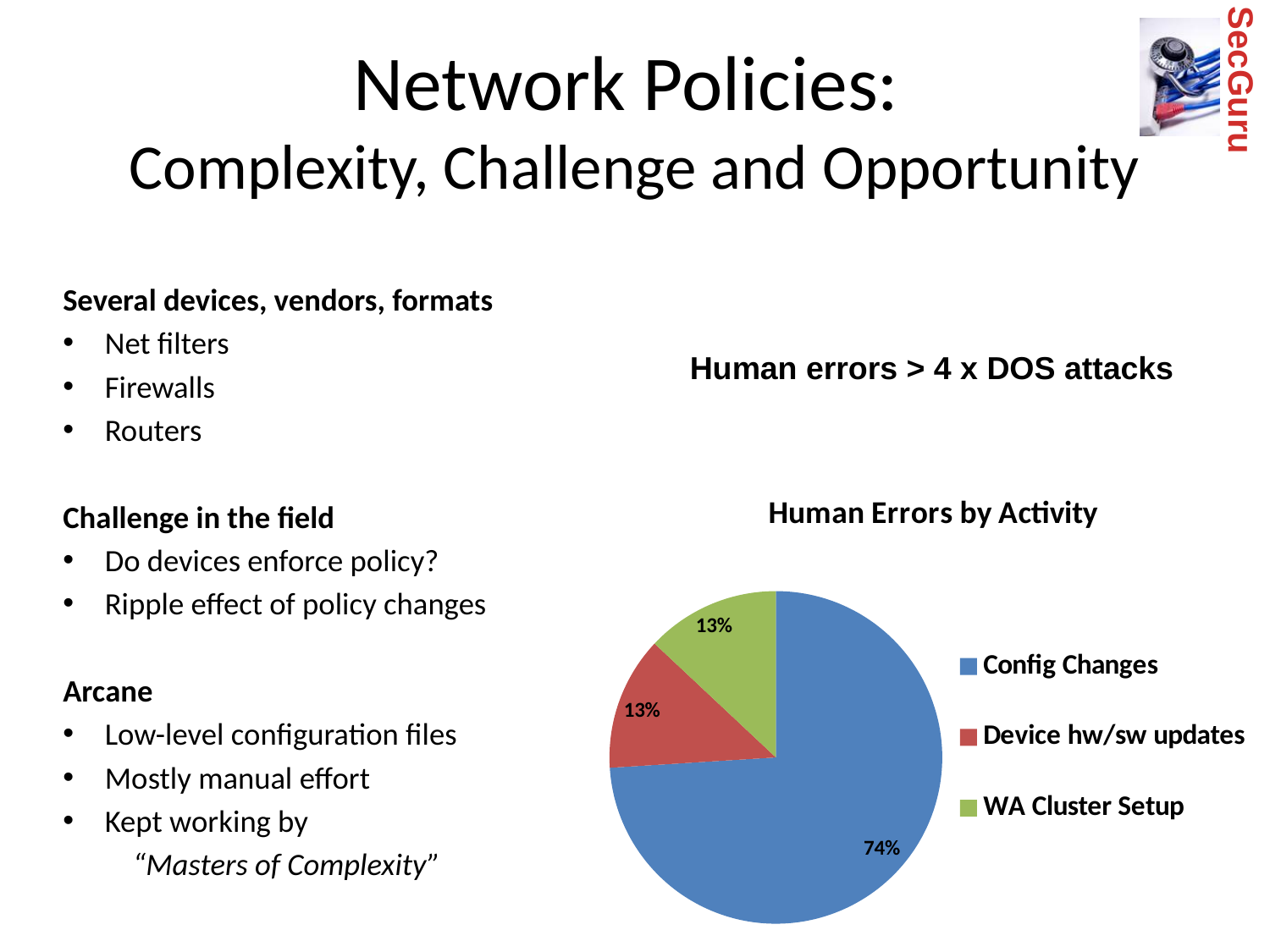
Is the share for Config Changes greater or less than 50%? greater What share of human errors is attributed to WA Cluster Setup? 13% Which is larger, the share for Config Changes or the share for Device hw/sw updates? Config Changes What type of chart is shown on the slide? pie chart What share of human errors is attributed to Config Changes? 74% Which activity accounts for the largest share of human errors? Config Changes How many entries does the legend list? 3 What is the title of the chart? Human Errors by Activity What share of human errors is attributed to Device hw/sw updates? 13% What colour is the Config Changes slice? blue What is the difference in percentage points between the Config Changes slice and the WA Cluster Setup slice? 61 How many slices does the pie chart have? 3